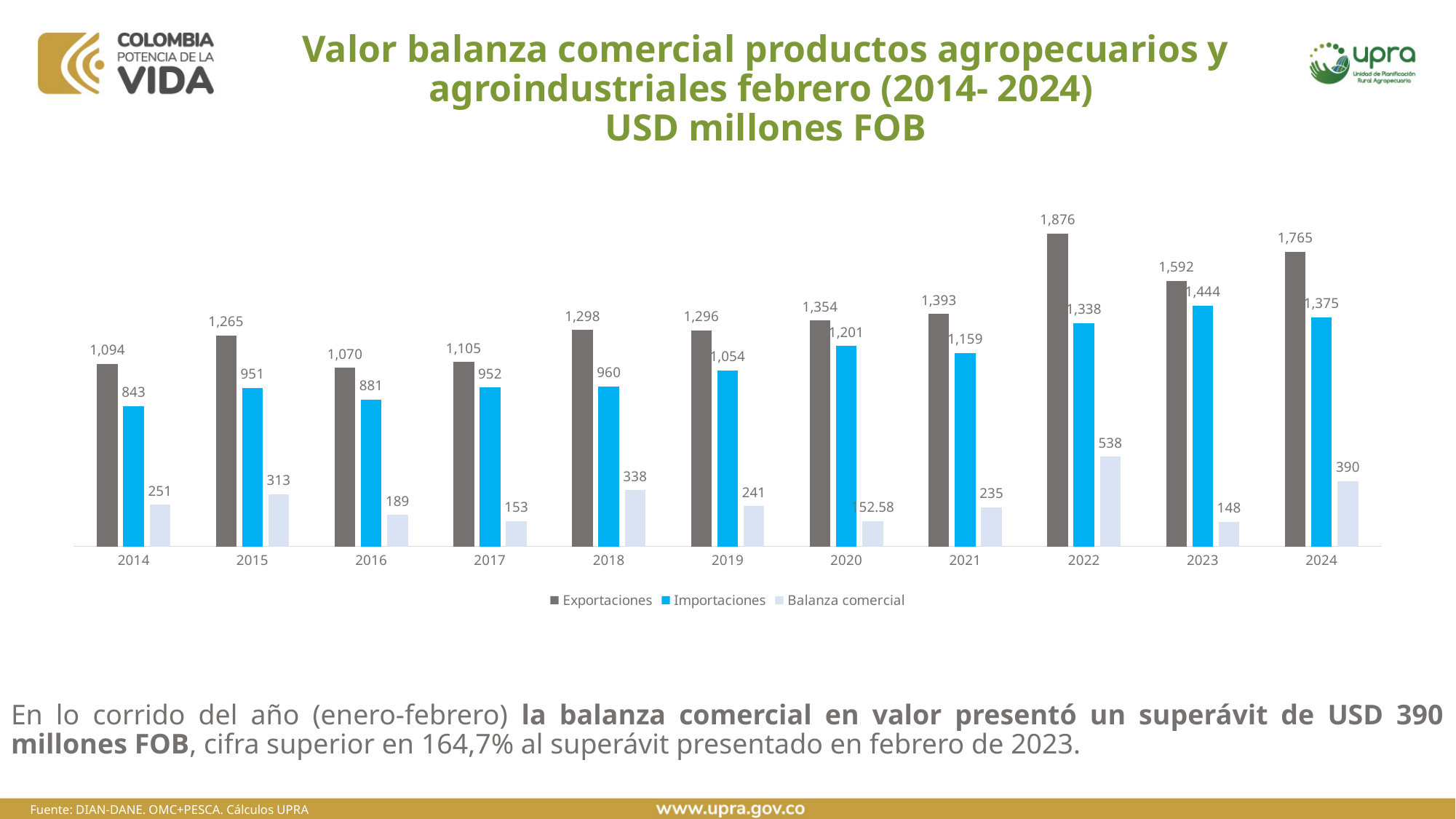
How many series does the legend list? 3 What is the value of Exportaciones for 2022? 1,876 What kind of chart is shown on the slide? Bar chart What is the value of Balanza comercial for 2020? 152.58 Which is larger, Importaciones in 2023 or Importaciones in 2024? Importaciones in 2023 Which year has the lowest value for Balanza comercial? 2023 What is the difference between Exportaciones and Importaciones in 2024? 390 How many years are shown on the x axis? 11 Which year has the highest value for Exportaciones? 2022 Which series is shown in blue in the legend? Importaciones What is the value of Importaciones for 2019? 1,054 Does the value of Importaciones rise or fall from 2014 to 2018? Rise